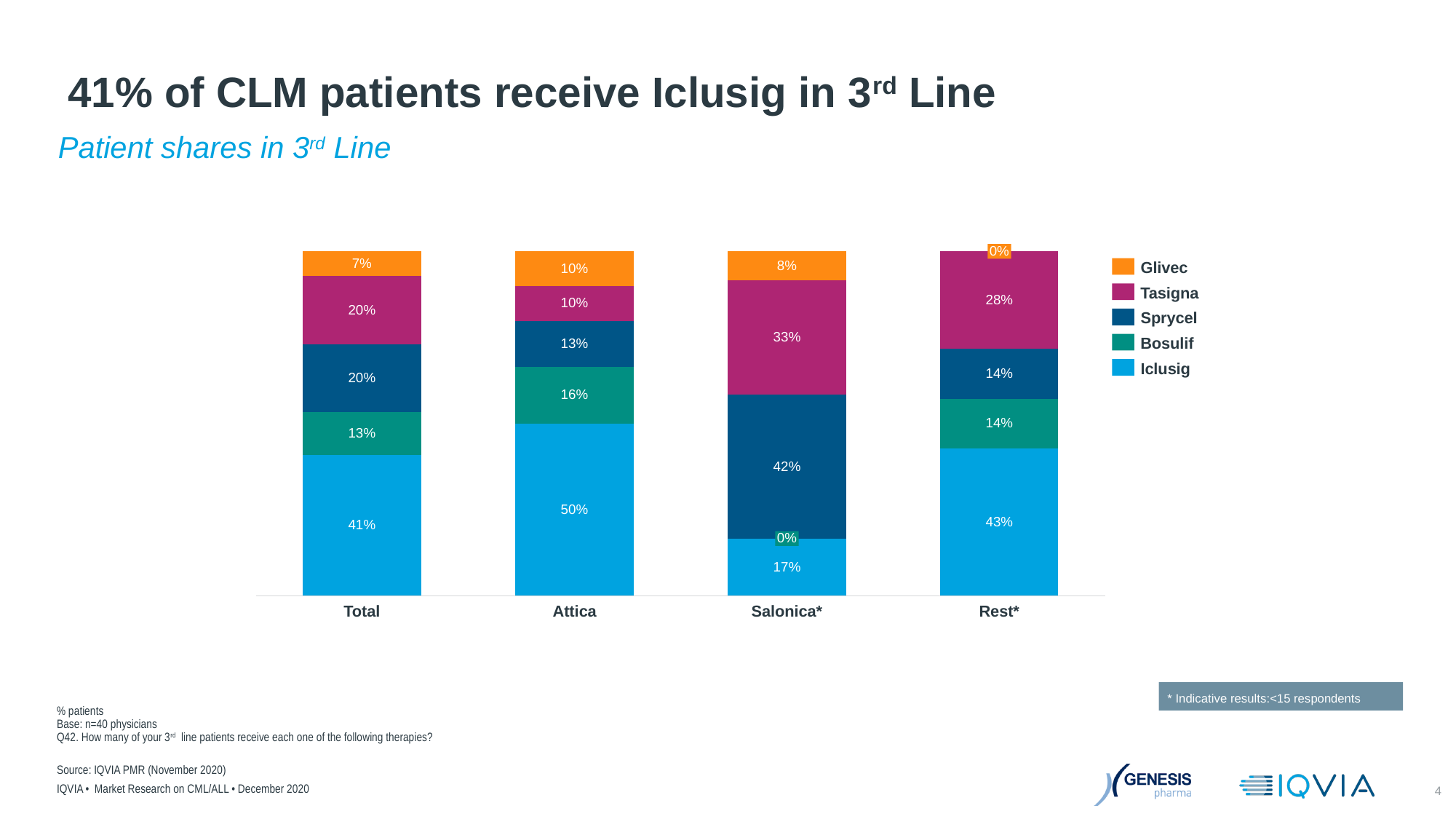
Which category has the highest Iclusig share? Attica How many categories are shown on the x axis? 4 What kind of chart is shown on the slide? Stacked bar chart What is the Glivec share for Total? 7% Which category has the lowest Tasigna share? Attica What is the Sprycel share for Salonica*? 42% Which is larger, the Sprycel share for Salonica* or the Sprycel share for Rest*? Salonica* What is the Iclusig share for Attica? 50% What is the Bosulif share for Salonica*? 0% How many series does the legend list? 5 What is the Tasigna share for Rest*? 28% What is the difference between the Iclusig share for Attica and the Iclusig share for Salonica*? 33%